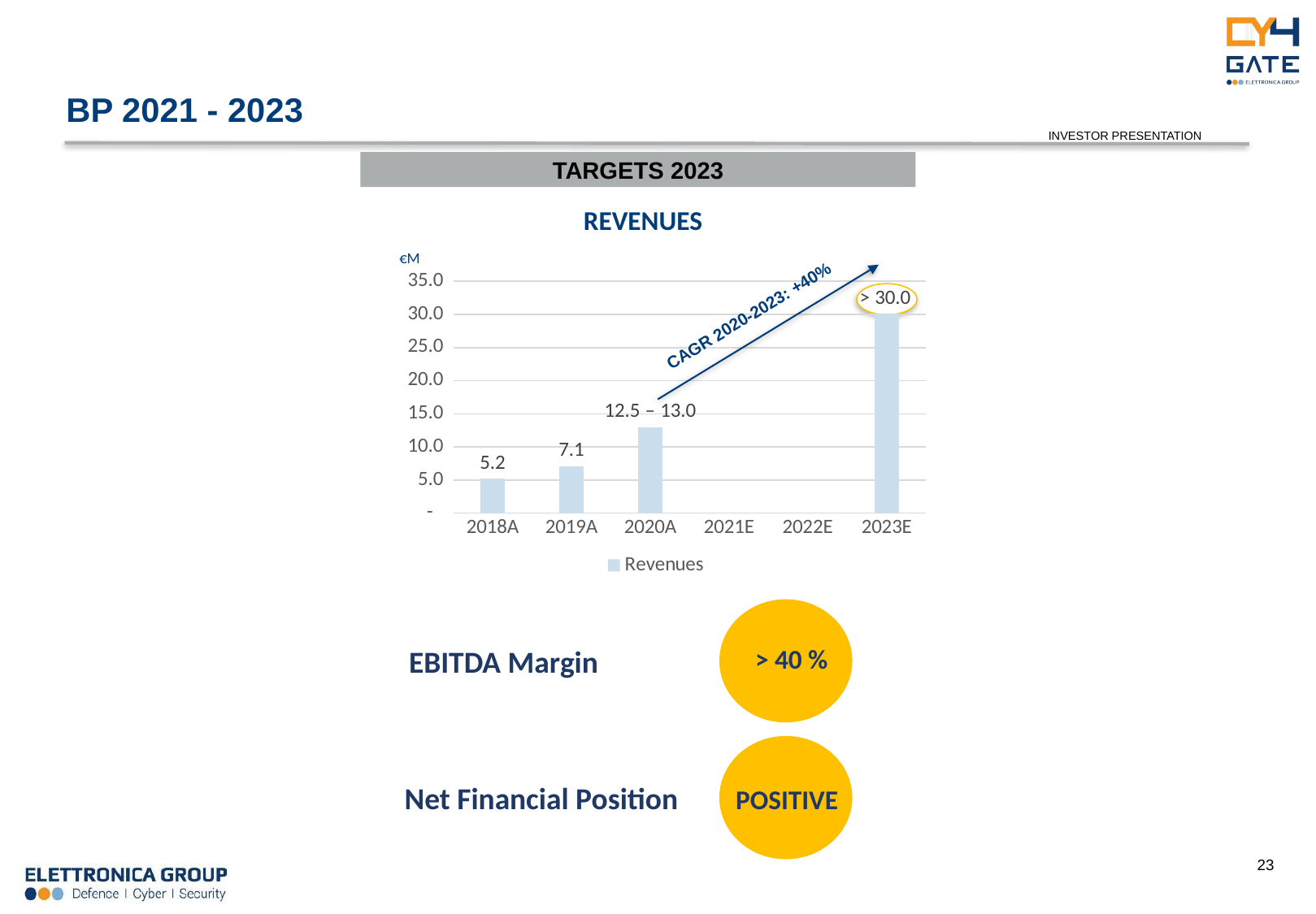
What CAGR for 2020-2023 is annotated on the chart? +40% What is the revenue value shown for 2018A? 5.2 Which year has the lowest revenue bar? 2018A Which year has the highest revenue bar? 2023E Which year has the larger revenue bar, 2018A or 2019A? 2019A What is the difference between the revenue values for 2019A and 2018A? 1.9 What is the revenue value shown for 2019A? 7.1 What revenue range is labelled for 2020A? 12.5 – 13.0 What is the revenue label shown for 2023E? > 30.0 Is the value for 2023E greater or less than 25.0? greater How many year categories are shown on the x axis of the revenues chart? 6 What kind of chart is used to show revenues? bar chart